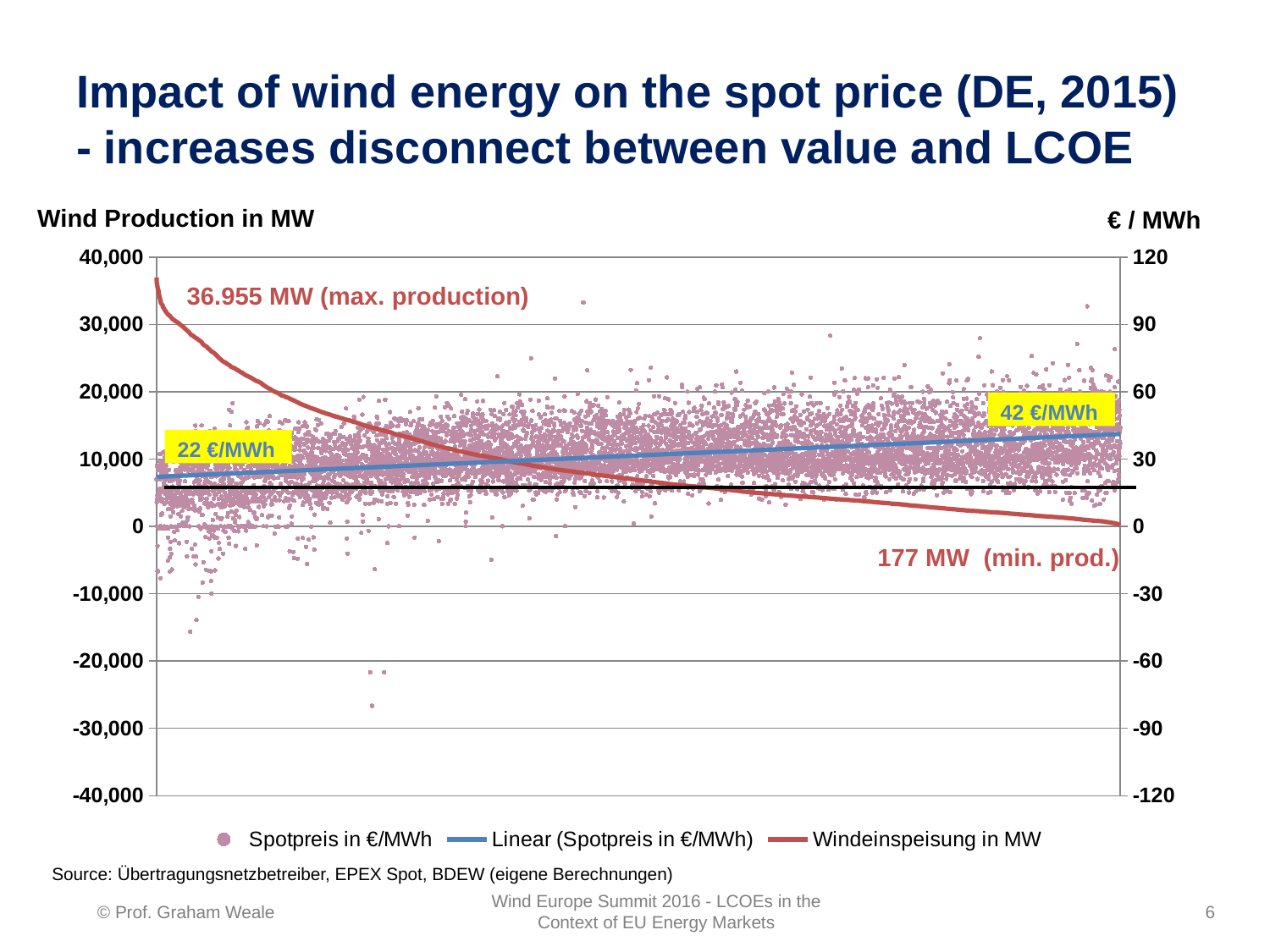
What spot price value is labelled at the right end of the linear trend line? 42 €/MWh What is the highest tick value shown on the right-hand (€ / MWh) axis? 120 Which legend series is drawn as the red line? Windeinspeisung in MW What is the minimum wind production value labelled on the chart? 177 MW Which is larger, the labelled maximum production (36.955 MW) or the labelled minimum production (177 MW)? 36.955 MW (max. production) What is the maximum wind production value labelled on the chart? 36.955 MW How many series does the legend list? 3 What is the difference between the two labelled spot price values on the linear trend line (42 €/MWh and 22 €/MWh)? 20 €/MWh What is the label of the left-hand vertical axis? Wind Production in MW What spot price value is labelled at the left end of the linear trend line? 22 €/MWh Does the Linear (Spotpreis in €/MWh) line rise or fall from left to right? rise Does the Windeinspeisung in MW line rise or fall from left to right? fall